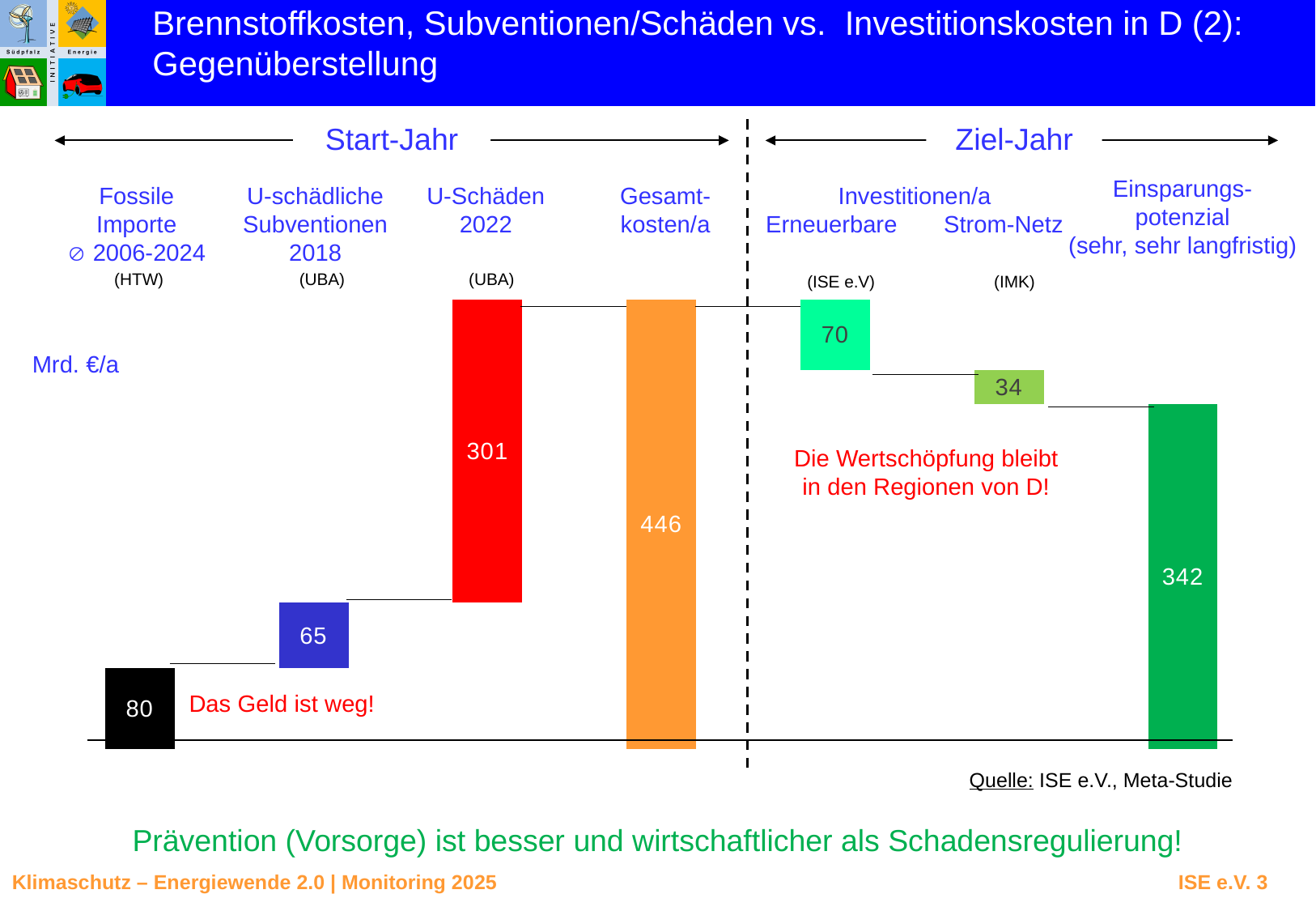
What is the value shown for Einsparungspotenzial? 342 What is the value shown for Investitionen/a Strom-Netz? 34 What is the value shown for U-Schäden 2022? 301 What type of chart is shown on the slide? Bar chart What is the value shown for Gesamtkosten/a? 446 Which category has the highest value in the chart? Gesamtkosten/a What is the value shown for Fossile Importe (2006-2024)? 80 What is the difference between U-Schäden 2022 and U-schädliche Subventionen 2018? 236 What is the value shown for U-schädliche Subventionen 2018? 65 What unit is given for the values in the chart? Mrd. €/a Which is larger: Investitionen/a Erneuerbare or Investitionen/a Strom-Netz? Investitionen/a Erneuerbare Which category has the lowest value in the chart? Investitionen/a Strom-Netz